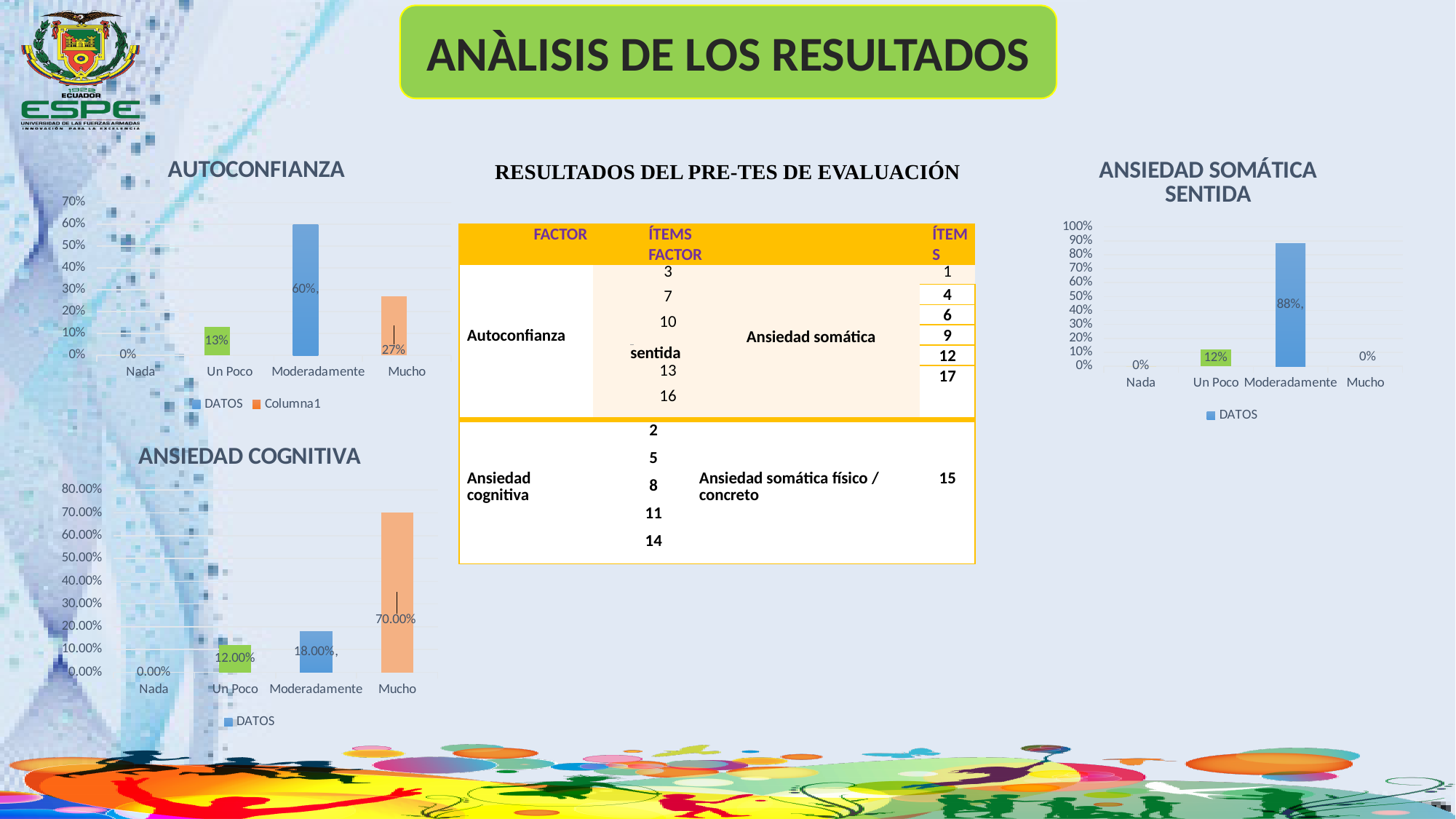
In the ANSIEDAD COGNITIVA chart, what is the difference between the values for Mucho and Moderadamente? 52.00% In the ANSIEDAD COGNITIVA chart, which is larger, the value for Moderadamente or the value for Un Poco? Moderadamente In the ANSIEDAD SOMÁTICA SENTIDA chart, what is the value for Un Poco? 12% How many categories are shown on the x axis of the ANSIEDAD COGNITIVA chart? 4 In the ANSIEDAD COGNITIVA chart, what is the value for Mucho? 70.00% In the AUTOCONFIANZA chart, what is the value for Moderadamente? 60% What kind of chart is the ANSIEDAD SOMÁTICA SENTIDA chart? Bar chart How many entries does the legend of the AUTOCONFIANZA chart list? 2 In the AUTOCONFIANZA chart, what is the difference between the values for Mucho and Un Poco? 14% In the AUTOCONFIANZA chart, which category has the highest value? Moderadamente In the ANSIEDAD SOMÁTICA SENTIDA chart, what is the value for Moderadamente? 88% What is the name of the series in the legend of the ANSIEDAD SOMÁTICA SENTIDA chart? DATOS